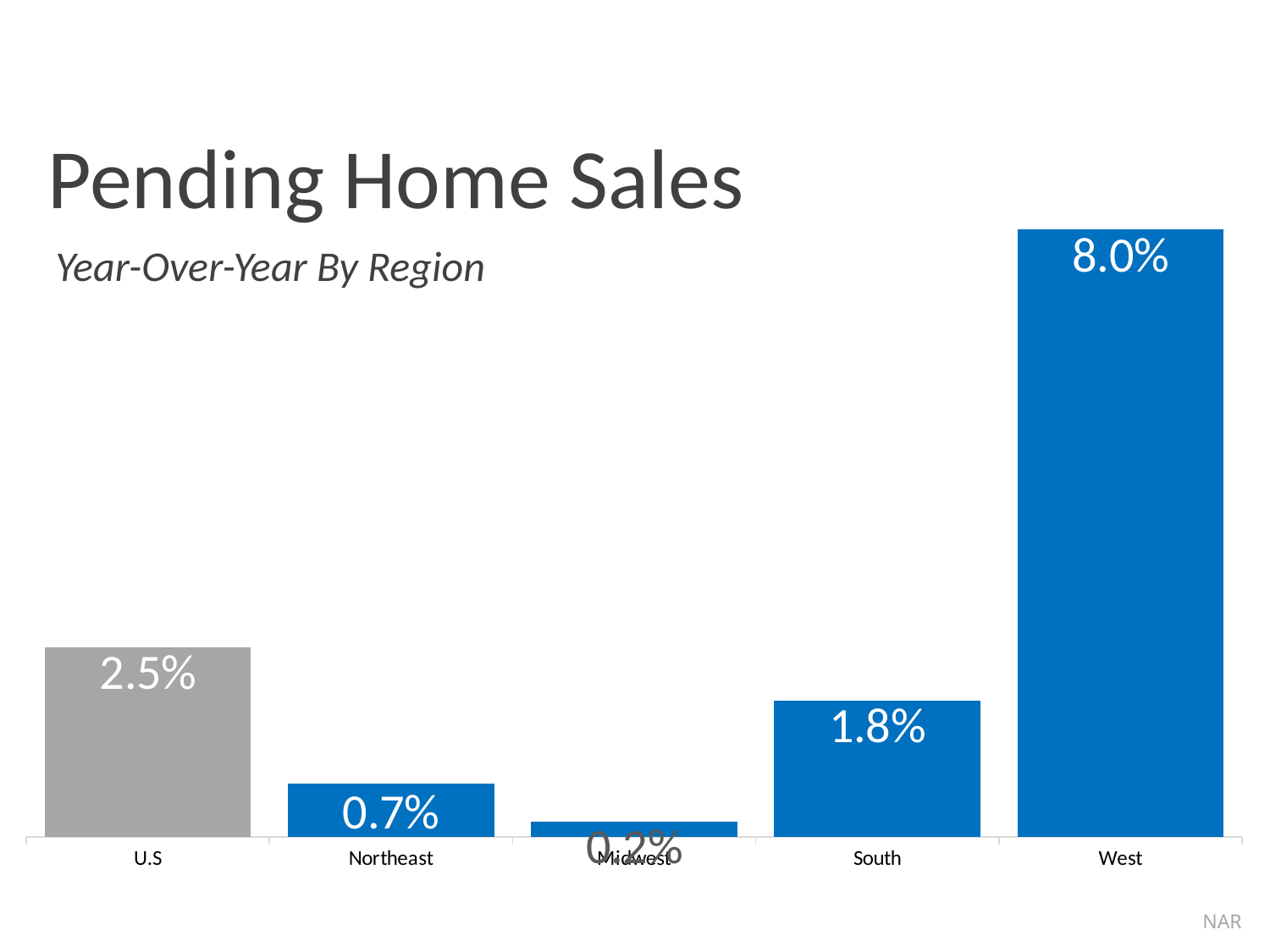
Which category has the lowest value on the chart? Midwest What is the value for the West region? 8.0% What is the difference between the West value and the U.S value? 5.5% Which region has the highest pending home sales growth? West What is the value for the U.S bar? 2.5% What kind of chart is shown on the slide? Bar chart Which is larger, the value for South or the value for Northeast? South What is the difference between the South value and the Northeast value? 1.1% What is the subtitle of the chart? Year-Over-Year By Region What is the value for the Northeast region? 0.7% How many categories are shown on the chart? 5 What is the value for the South region? 1.8%